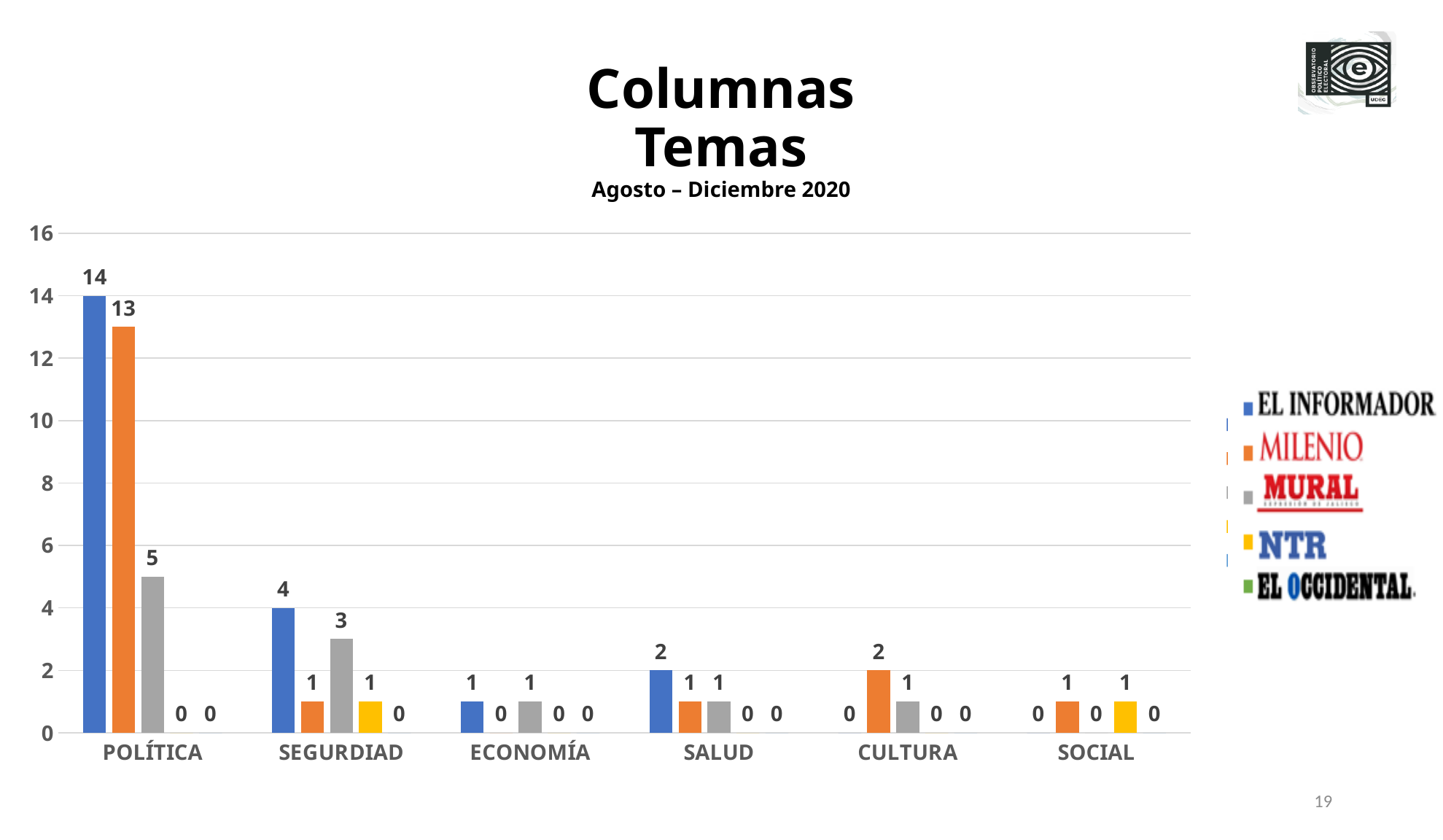
How many series does the legend list? 5 What is the value for El Informador in the POLÍTICA category? 14 Is the value for Milenio in the POLÍTICA category greater or less than 10? greater What is the value for Milenio in the CULTURA category? 2 Which is larger in the SEGURDIAD category, the value for El Informador or the value for Mural? El Informador What is the difference between the El Informador and Mural values in the POLÍTICA category? 9 How many categories are shown on the x axis? 6 What period is given in the subtitle of the chart? Agosto – Diciembre 2020 What is the value for Milenio in the POLÍTICA category? 13 What is the value for Mural in the SEGURDIAD category? 3 Which category has the highest value for El Informador? POLÍTICA What kind of chart is shown on the slide? bar chart